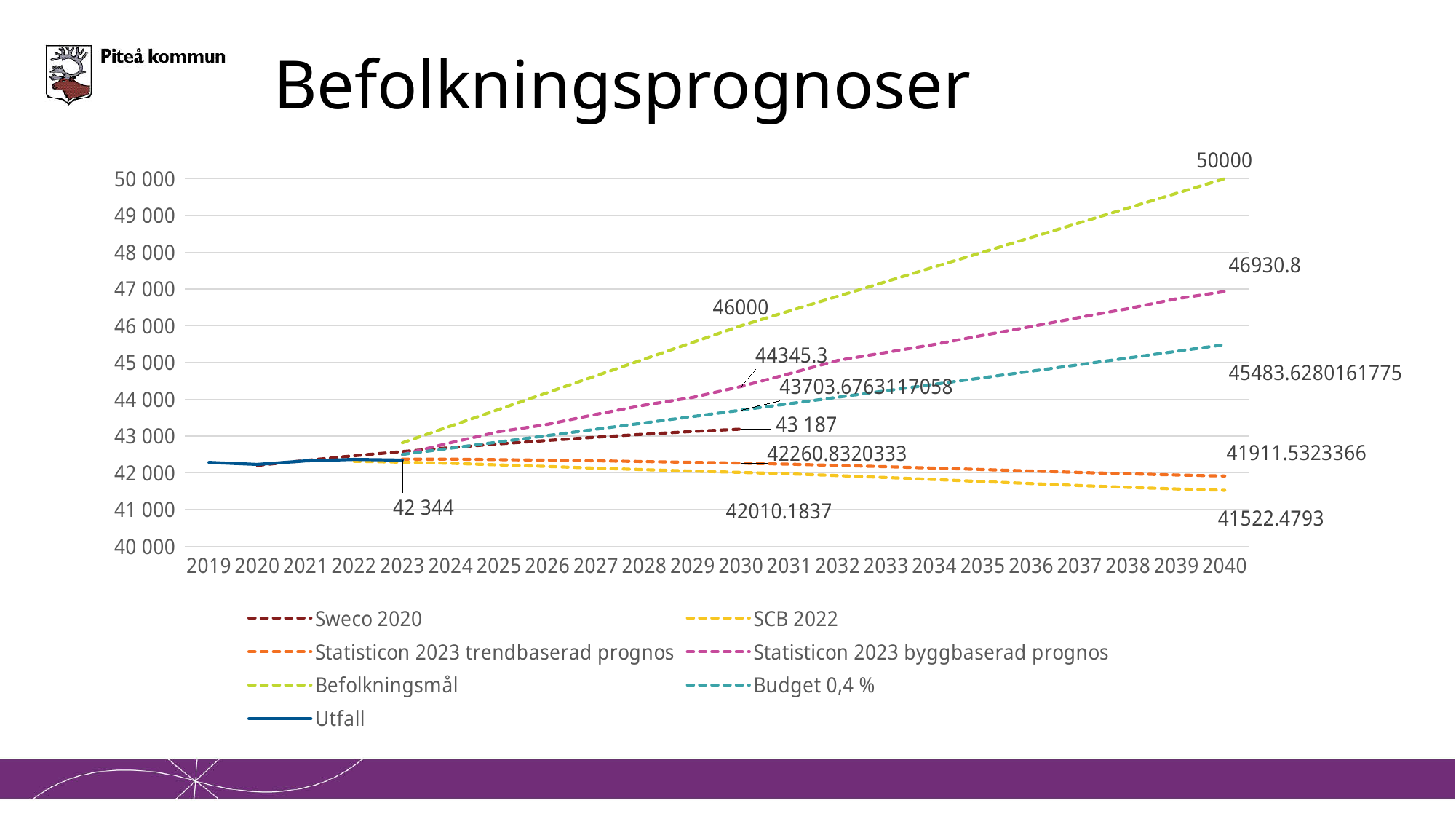
In 2040, which is larger: Budget 0,4 % or Statisticon 2023 trendbaserad prognos? Budget 0,4 % What is the value of Befolkningsmål in 2040? 50000 What is the value of Sweco 2020 in 2030? 43 187 What is the value of Statisticon 2023 byggbaserad prognos in 2040? 46930.8 By how much does Befolkningsmål increase from 2030 to 2040? 4000 What is the value of Utfall in 2023? 42 344 Which series has the highest value in 2040? Befolkningsmål Does the SCB 2022 series rise or fall from 2023 to 2040? fall Is the value for Utfall in 2019 greater or less than 43 000? less Which series has the lowest value in 2040? SCB 2022 What kind of chart is shown on the slide? line chart How many series does the legend list? 7